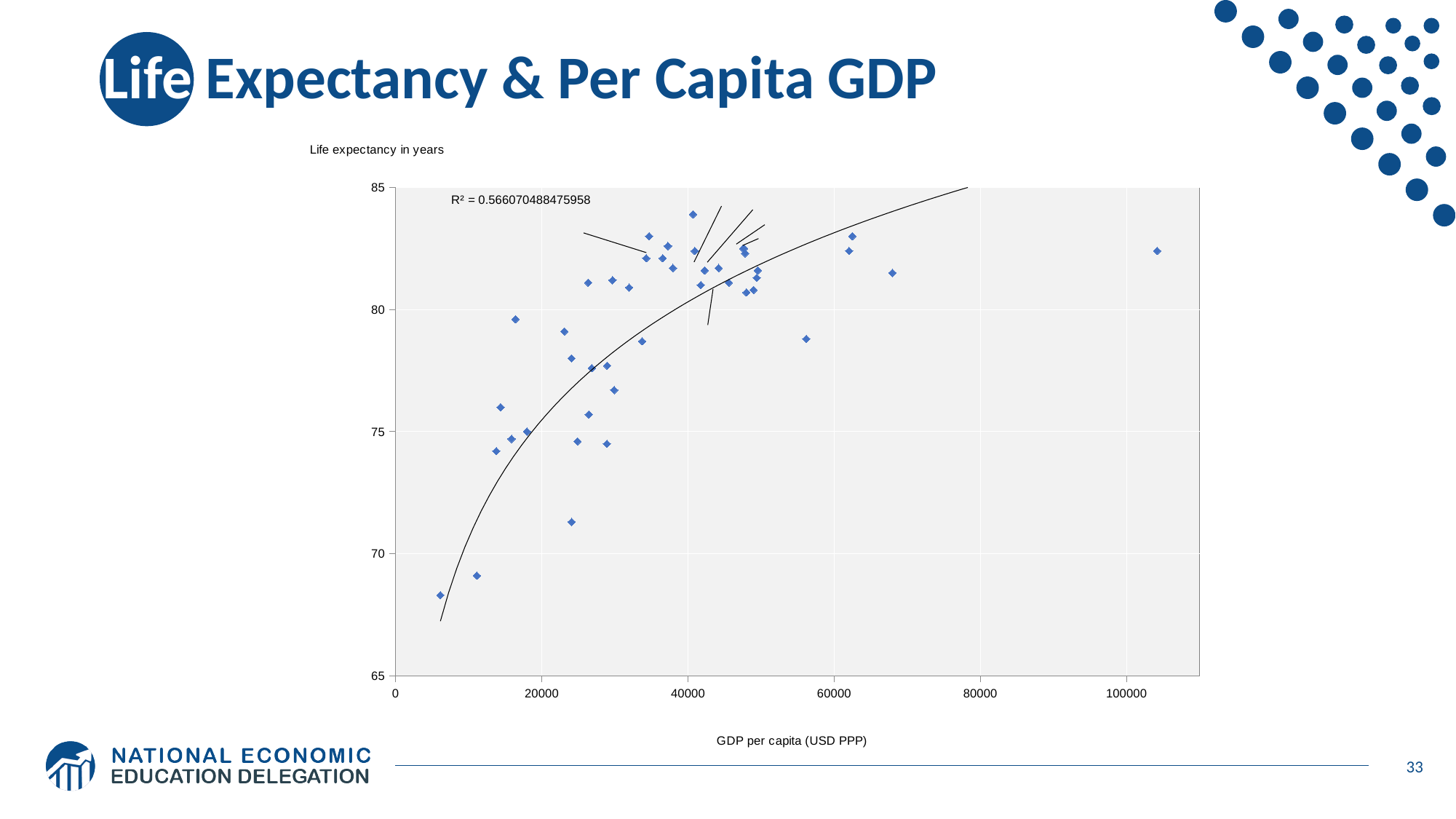
Is the GDP per capita of the point with the lowest life expectancy greater or less than 20000? less What is the label of the x axis? GDP per capita (USD PPP) Which has the higher life expectancy: the point with the lowest GDP per capita or the point with the highest GDP per capita? the point with the highest GDP per capita What kind of chart is shown on the slide? scatter chart As GDP per capita increases along the x axis, does life expectancy generally rise or fall? rise Is the life expectancy of the point with the lowest GDP per capita greater or less than 70? less Is the life expectancy of the point with the highest GDP per capita greater or less than 80? greater What R² value is printed on the chart? R² = 0.566070488475958